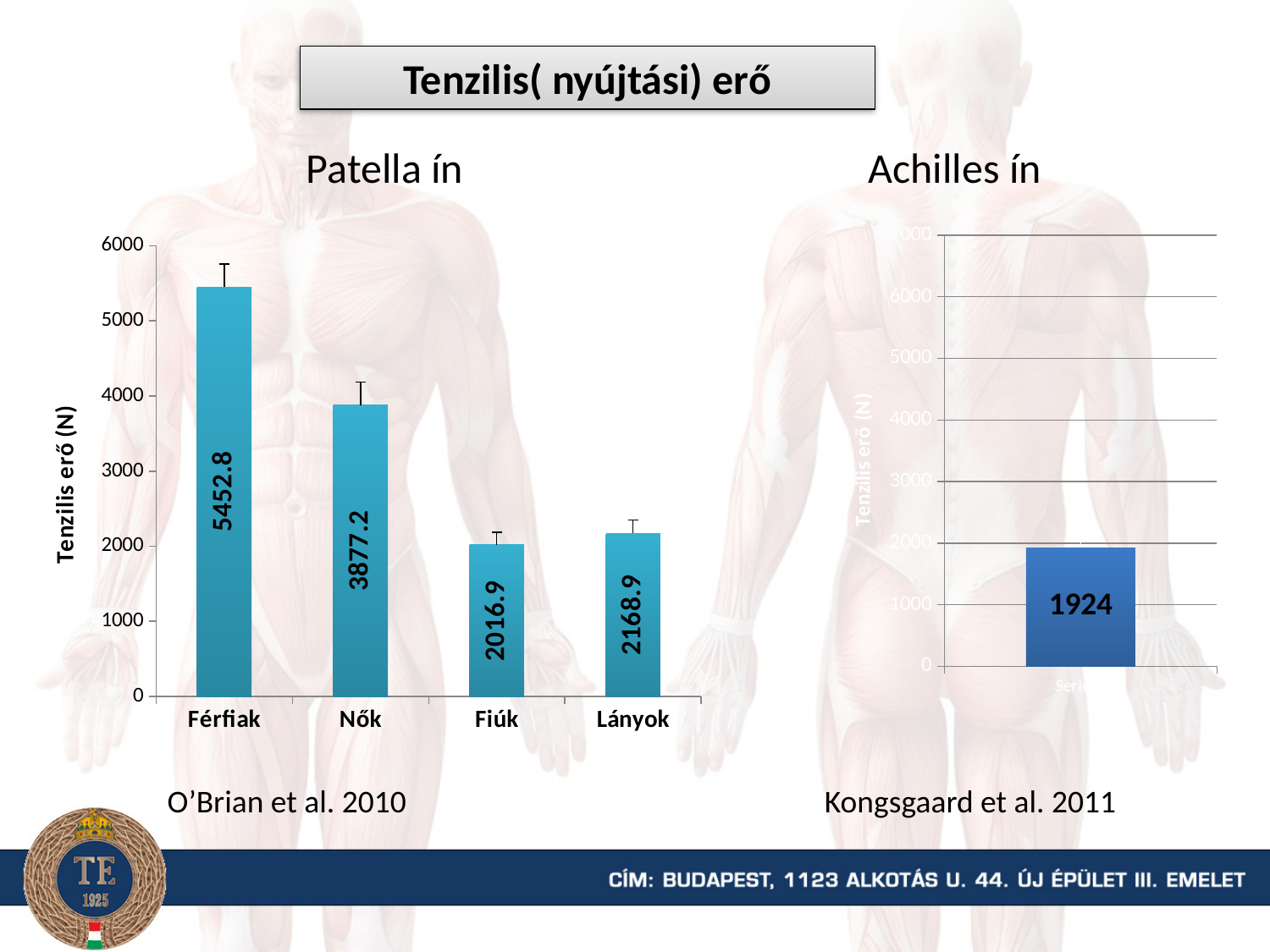
In the Patella ín chart, is the value for Nők greater or less than 3000? greater In the Achilles ín chart, what is the value shown on the bar? 1924 In the Patella ín chart, what is the value for Lányok? 2168.9 What kind of chart is the Patella ín chart? bar chart How many categories are shown in the Patella ín chart? 4 In the Patella ín chart, which is larger, the value for Fiúk or the value for Lányok? Lányok What is the y-axis label of the Patella ín chart? Tenzilis erő (N) In the Patella ín chart, what is the difference between the values for Férfiak and Nők? 1575.6 In the Patella ín chart, which category has the lowest value? Fiúk In the Patella ín chart, which category has the highest value? Férfiak In the Patella ín chart, what is the value for Nők? 3877.2 In the Patella ín chart, what is the value for Férfiak? 5452.8